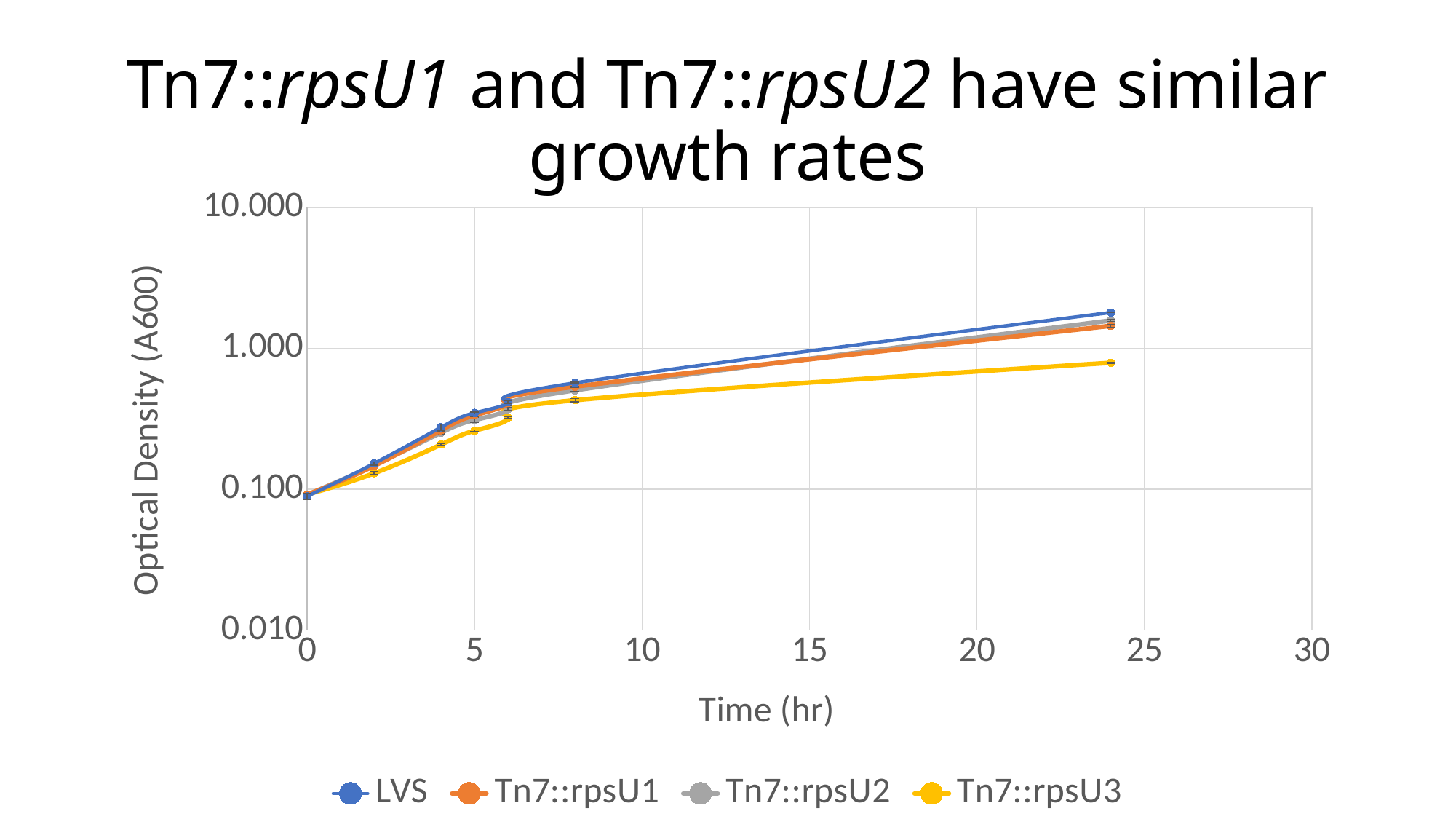
What kind of chart is shown on the slide? line chart Is the optical density of Tn7::rpsU1 at 8 hr greater or less than 1.000? less Is the optical density of LVS at 2 hr greater or less than 0.100? greater Do the optical density values rise or fall as time increases? rise At 24 hr, which is larger: the optical density of LVS or of Tn7::rpsU3? LVS What is the label of the y axis? Optical Density (A600) Which series has the lowest optical density at 24 hr? Tn7::rpsU3 Is the optical density of LVS at 24 hr greater or less than 1.000? greater Which series has the highest optical density at 24 hr? LVS What colour is the Tn7::rpsU3 line? yellow How many series does the legend list? 4